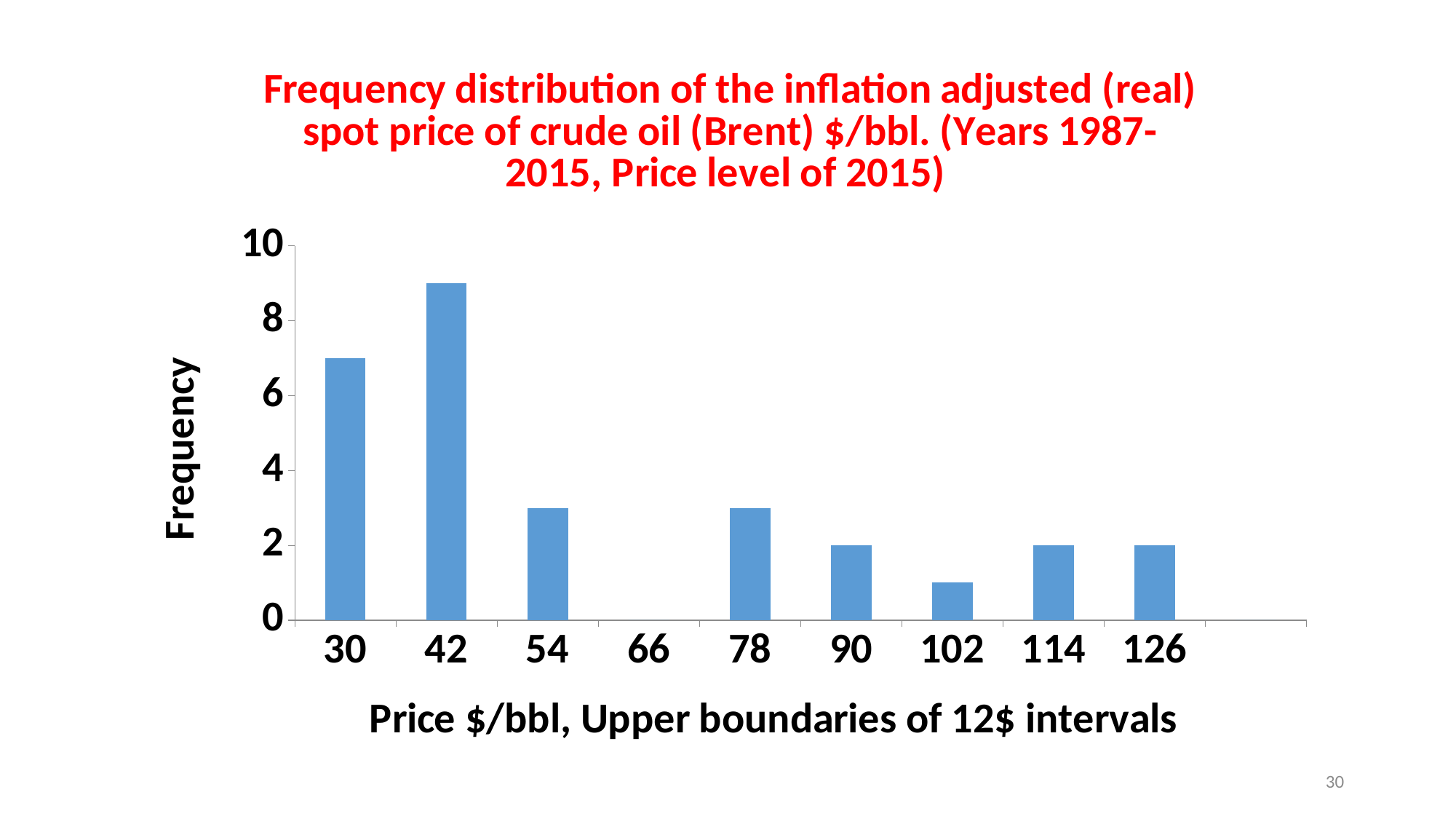
What is the frequency for the 126 price category? 2 Which price category has the lowest frequency? 66 What is the frequency for the 66 price category? 0 Which has the higher frequency, the 30 or the 42 price category? 42 Is the frequency for the 102 price category greater or less than 2? less Is the frequency for the 30 price category greater or less than 6? greater What kind of chart is shown on the slide? Bar chart What is the label of the y axis? Frequency How many price categories are shown on the x axis? 9 Which price category has the highest frequency? 42 Is the frequency for the 42 price category greater or less than 8? greater What is the frequency for the 90 price category? 2